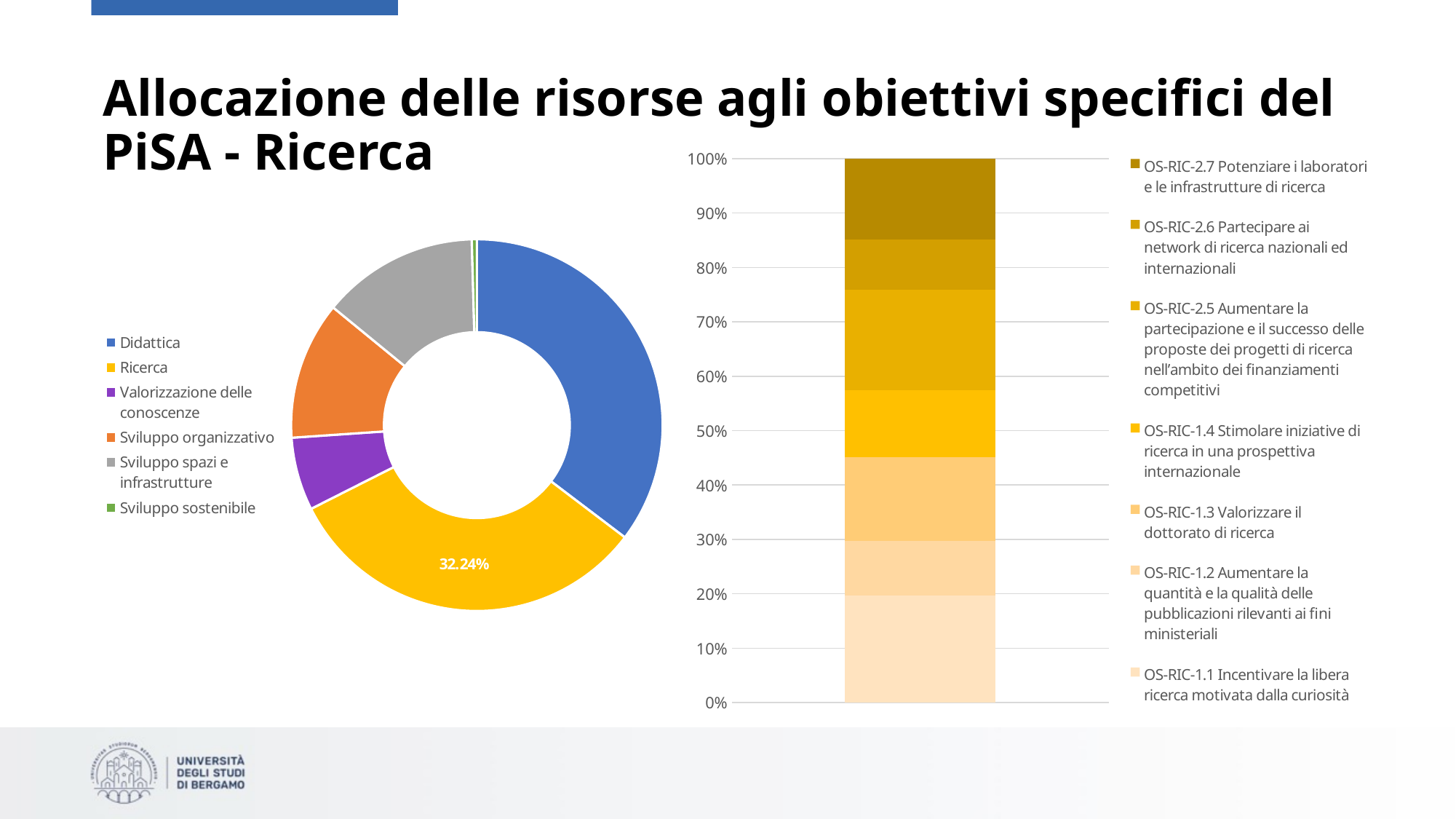
How many categories does the doughnut chart on the left show? 6 In the doughnut chart on the left, which slice is larger: Sviluppo spazi e infrastrutture or Valorizzazione delle conoscenze? Sviluppo spazi e infrastrutture In the stacked bar chart on the right, what is the total height of the stacked bar? 100% In the stacked bar chart on the right, is the upper boundary of the OS-RIC-1.3 segment greater or less than 50%? less In the doughnut chart on the left, what share is shown for Ricerca? 32.24% What kind of chart is the chart on the left of the slide? Doughnut (pie) chart In the stacked bar chart on the right, which series forms the bottom segment of the bar? OS-RIC-1.1 Incentivare la libera ricerca motivata dalla curiosità How many series does the legend of the stacked bar chart on the right list? 7 In the doughnut chart on the left, which slice is larger: Didattica or Ricerca? Didattica In the doughnut chart on the left, which category has the smallest slice? Sviluppo sostenibile What kind of chart is the chart on the right of the slide? Stacked bar chart In the doughnut chart on the left, which category has the largest slice? Didattica